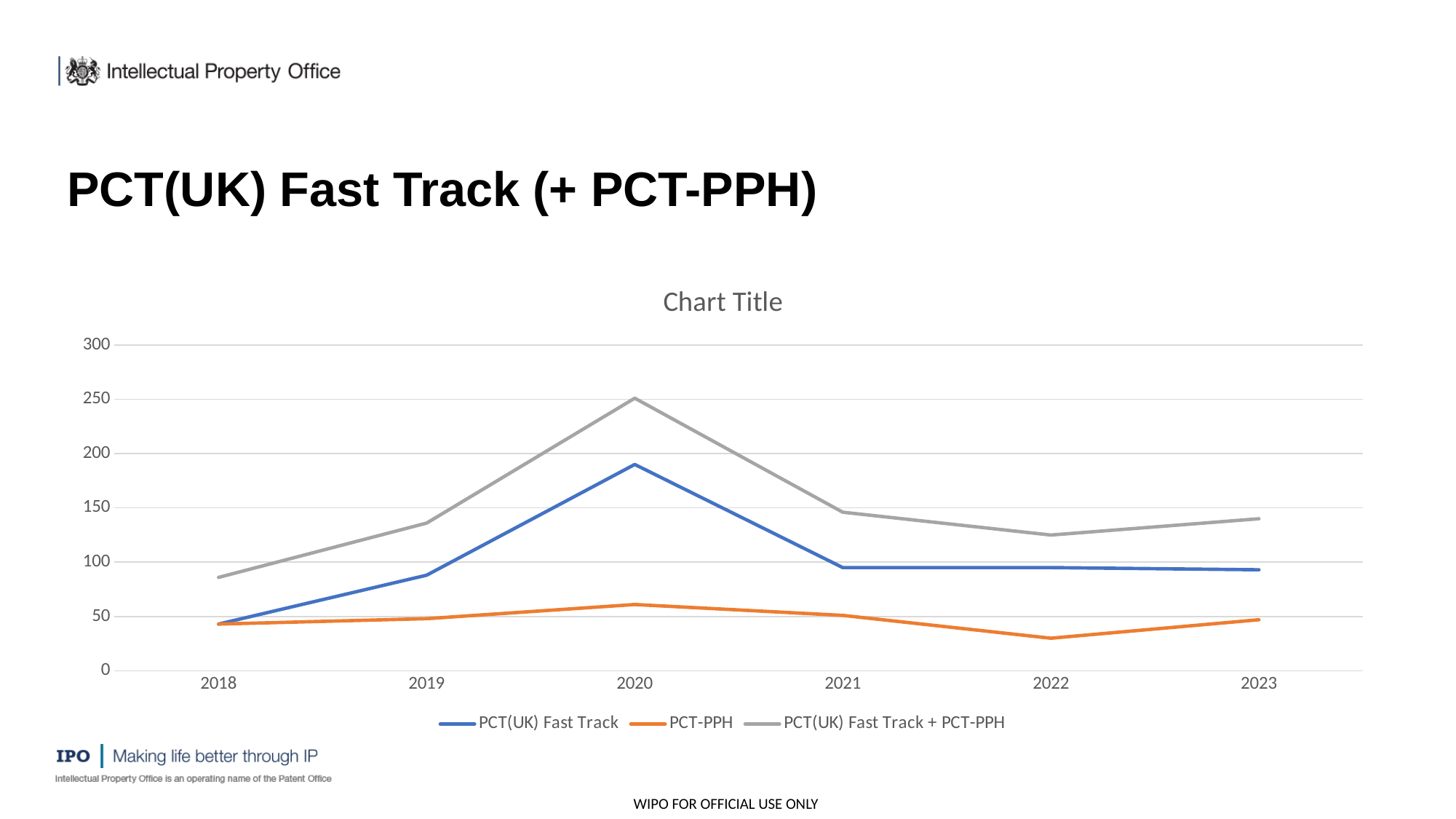
In which year is the PCT-PPH line at its lowest? 2022 What colour is the PCT-PPH line in the legend? Orange Is the value for PCT(UK) Fast Track in 2018 greater or less than 50? less How many years are shown on the x axis? 6 In which year does the PCT(UK) Fast Track line reach its highest value? 2020 Does the PCT(UK) Fast Track + PCT-PPH line rise or fall from 2020 to 2022? Fall How many series does the legend list? 3 In which year is the PCT(UK) Fast Track + PCT-PPH line at its lowest? 2018 Is the value for PCT(UK) Fast Track + PCT-PPH in 2020 greater or less than 200? greater In which year does the PCT(UK) Fast Track + PCT-PPH line reach its highest value? 2020 What type of chart is shown on the slide? Line chart Which series has the larger value in 2020, PCT(UK) Fast Track or PCT-PPH? PCT(UK) Fast Track